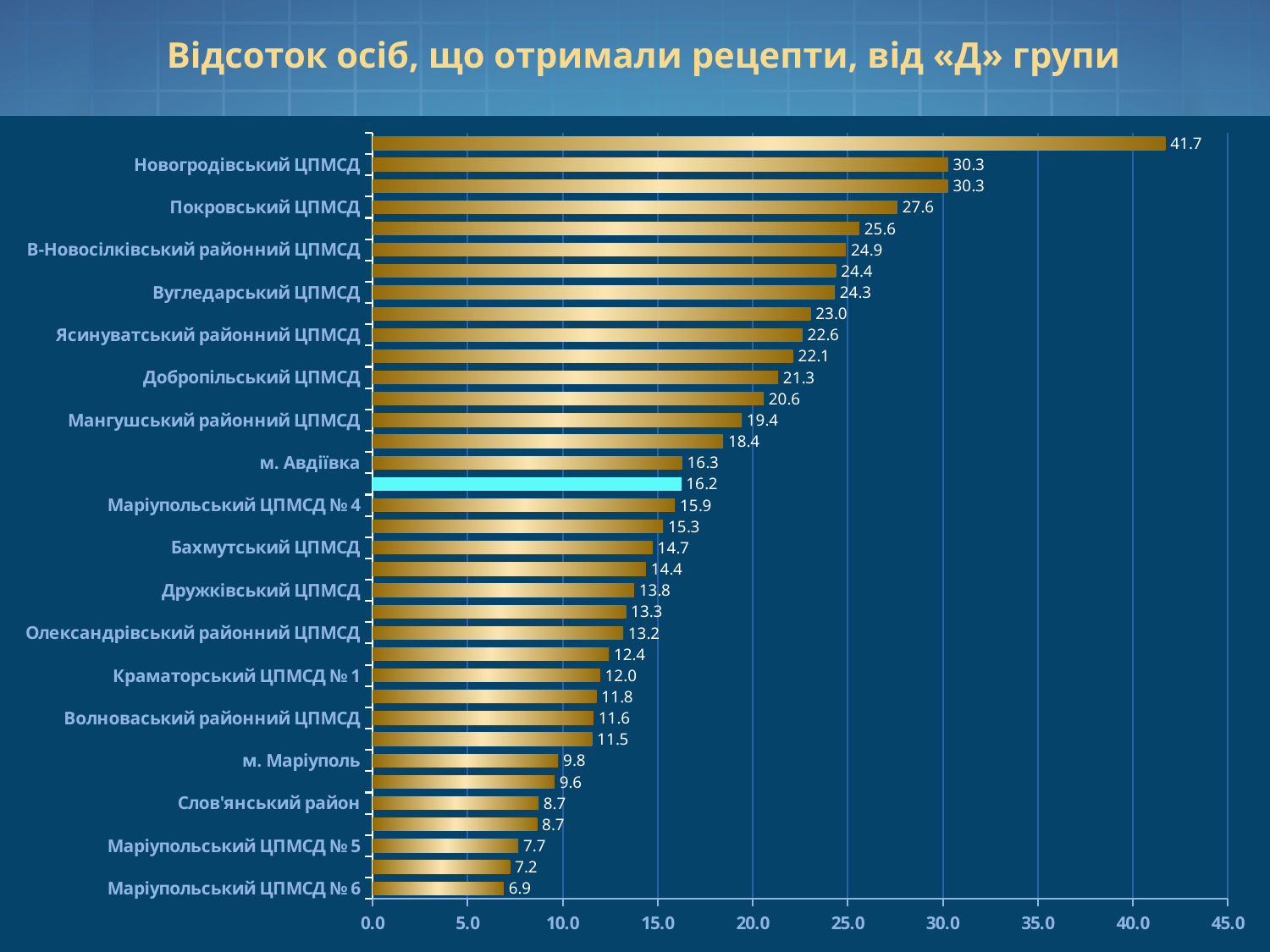
What is the difference between the values for Добропільський ЦПМСД and Дружківський ЦПМСД? 7.5 What is the value for Бахмутський ЦПМСД? 14.7 Is the value for Мангушський районний ЦПМСД greater or less than 20.0? less Which is larger, the value for Вугледарський ЦПМСД or for Ясинуватський районний ЦПМСД? Вугледарський ЦПМСД What is the value of the bar highlighted in light blue? 16.2 What is the highest value shown on the chart? 41.7 Which labelled category has the lowest value? Маріупольський ЦПМСД № 6 What type of chart is shown on the slide? Bar chart What is the value for м. Авдіївка? 16.3 What is the difference between the values for Новогродівський ЦПМСД and Покровський ЦПМСД? 2.7 What is the value for м. Маріуполь? 9.8 What is the value for Покровський ЦПМСД? 27.6